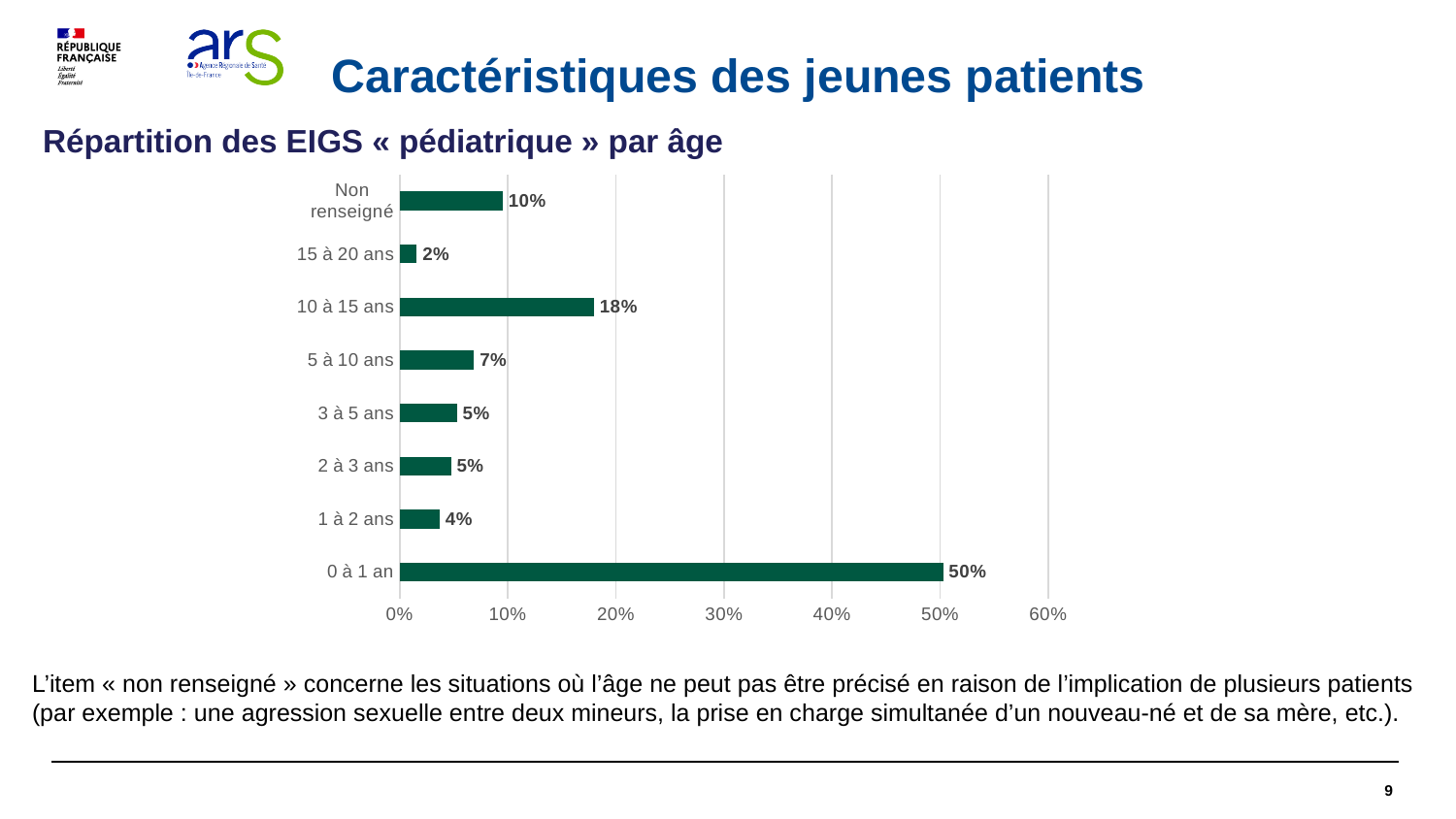
What is the difference between the values for "0 à 1 an" and "10 à 15 ans"? 32% Which age category has the lowest value? 15 à 20 ans How many categories are shown in the chart? 8 What is the title of the chart? Répartition des EIGS « pédiatrique » par âge Which is larger, the value for "1 à 2 ans" or the value for "5 à 10 ans"? 5 à 10 ans What is the value for the "0 à 1 an" category? 50% What kind of chart is shown on the slide? bar chart Which age category has the highest value? 0 à 1 an What is the value for the "5 à 10 ans" category? 7% What is the value for the "Non renseigné" category? 10% Is the value for "10 à 15 ans" greater or less than 20%? less What is the value for the "10 à 15 ans" category? 18%